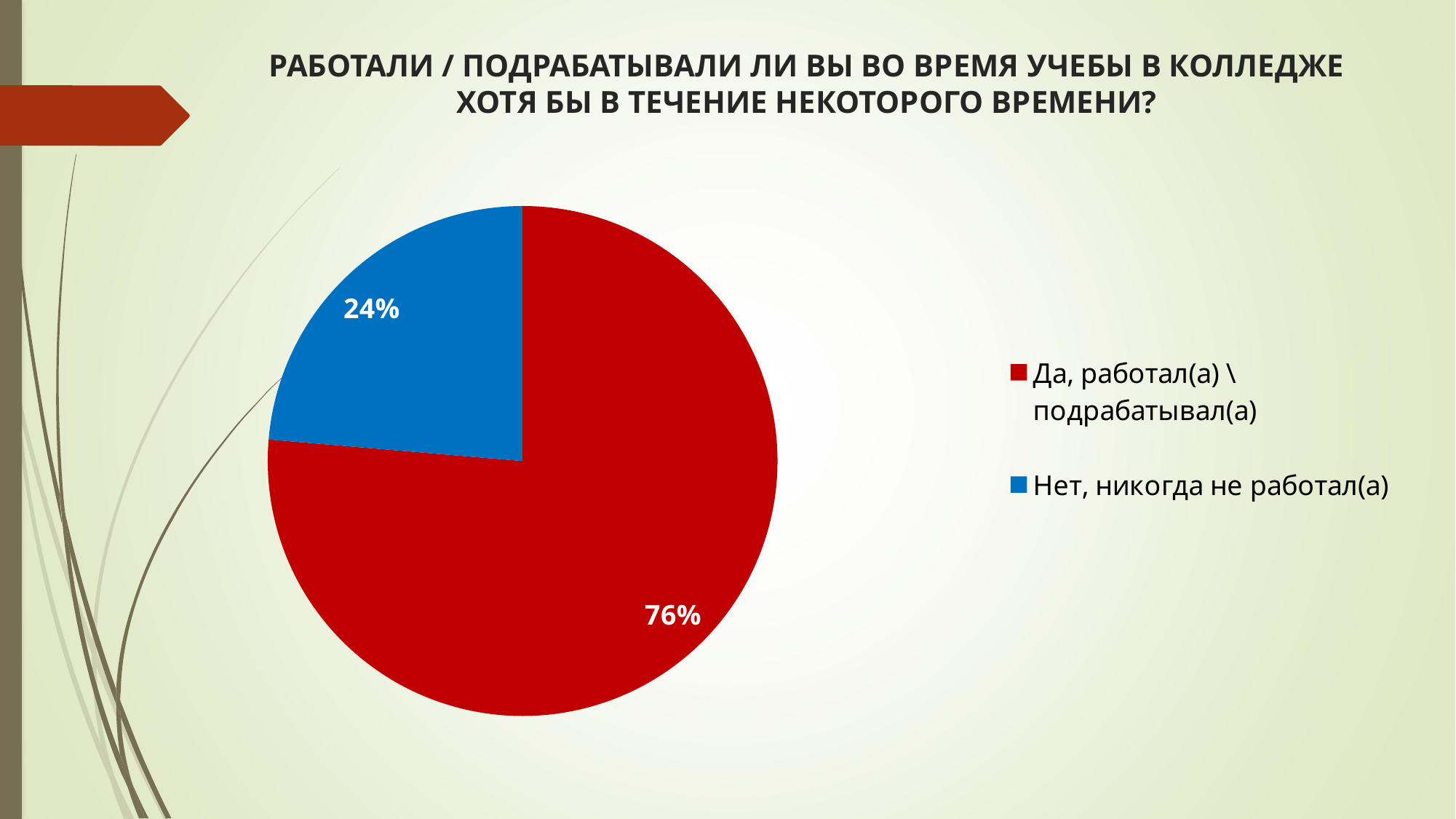
What share of respondents answered "Нет, никогда не работал(а)"? 24% Is the share for "Нет, никогда не работал(а)" greater or less than 50%? less What colour is the slice for "Нет, никогда не работал(а)"? blue What share of respondents answered "Да, работал(а) \ подрабатывал(а)"? 76% Which is larger: the share for "Да, работал(а) \ подрабатывал(а)" or the share for "Нет, никогда не работал(а)"? Да, работал(а) \ подрабатывал(а) What colour is the slice for "Да, работал(а) \ подрабатывал(а)"? red What is the difference in percentage points between the "Да, работал(а) \ подрабатывал(а)" slice and the "Нет, никогда не работал(а)" slice? 52 How many entries does the legend list? 2 How many slices does the pie chart have? 2 Which answer has the largest share of the pie? Да, работал(а) \ подрабатывал(а) Which answer has the smallest share of the pie? Нет, никогда не работал(а) What kind of chart is shown on the slide? pie chart